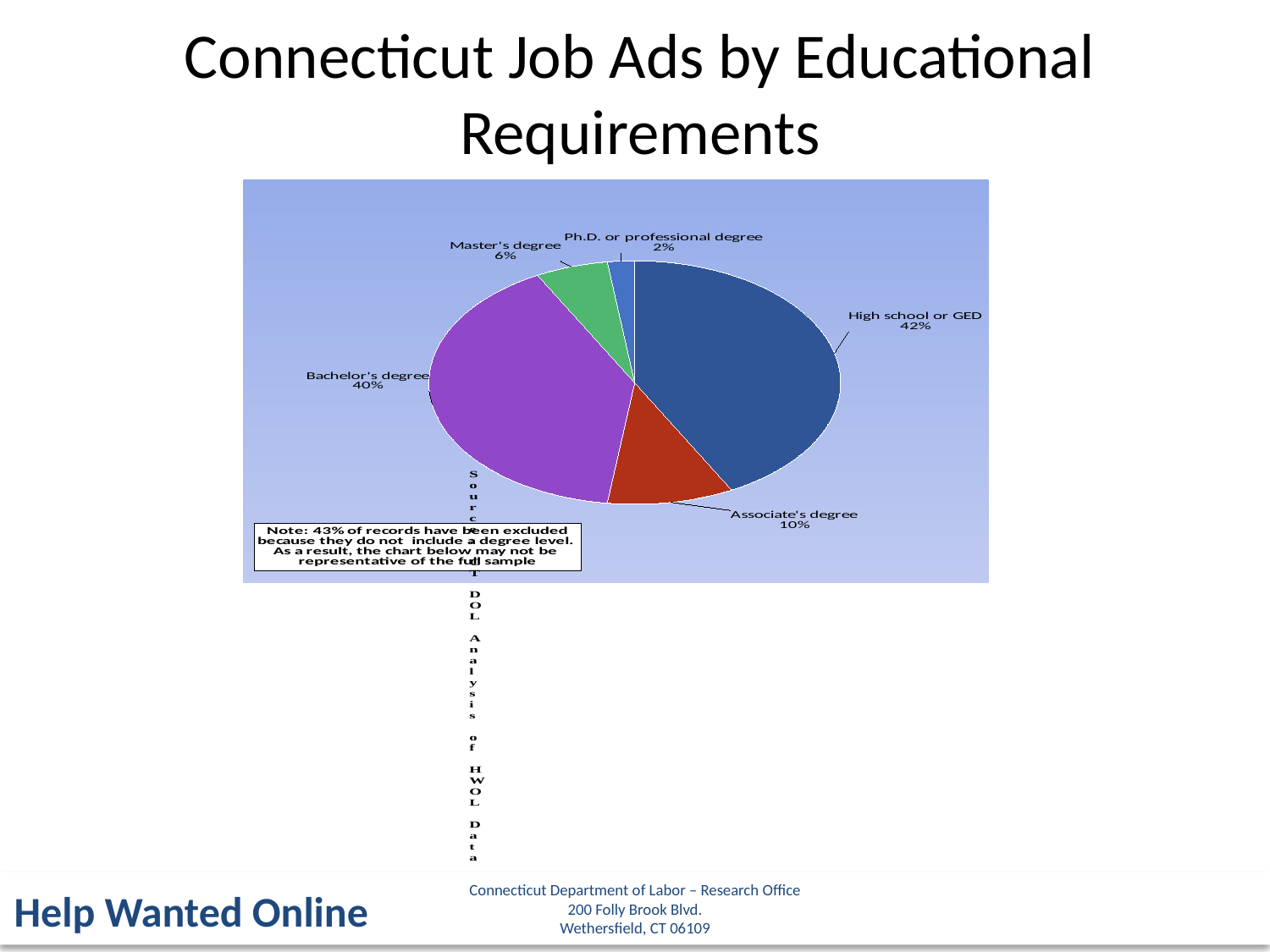
What share of job ads require a Ph.D. or professional degree? 2% Which educational requirement has the largest share of job ads? High school or GED Which is larger, the share for Associate's degree or the share for Master's degree? Associate's degree Which educational requirement has the smallest share of job ads? Ph.D. or professional degree How many educational requirement categories are shown in the pie chart? 5 What share of job ads require a Master's degree? 6% What is the difference in percentage points between the High school or GED share and the Bachelor's degree share? 2 percentage points What share of job ads require a Bachelor's degree? 40% What kind of chart is shown on the slide? pie chart According to the note on the chart, what percentage of records were excluded because they did not include a degree level? 43%